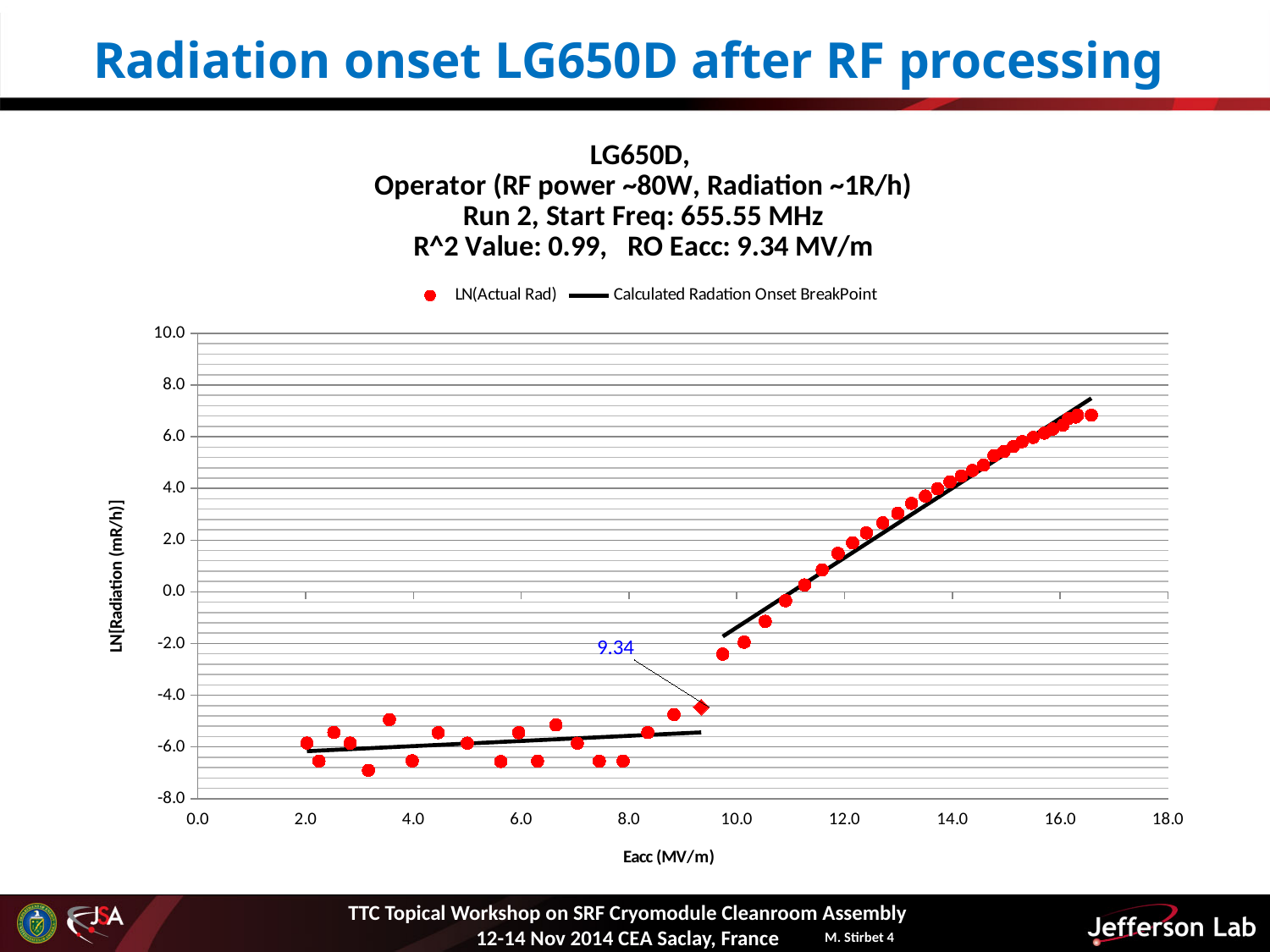
What is the maximum value shown on the y axis of the chart? 10.0 What is the label of the x axis of the chart? Eacc (MV/m) What are the two series named in the chart legend? LN(Actual Rad) and Calculated Radation Onset BreakPoint Is the LN(Actual Rad) value at the highest Eacc (around 16.5 MV/m) greater or less than 6.0? greater What kind of chart is shown on the slide? scatter chart What Eacc value is labeled at the calculated radiation onset breakpoint on the chart? 9.34 How many series does the chart legend list? 2 According to the chart title, what is the R^2 value of the fit? 0.99 Which is larger: the LN(Actual Rad) value at Eacc of about 14.0 MV/m or at about 10.0 MV/m? at about 14.0 MV/m Is the LN(Actual Rad) value at Eacc of about 2.0 MV/m greater or less than -4.0? less According to the chart title, what is the RO Eacc value? 9.34 MV/m Do the LN(Actual Rad) values rise or fall as Eacc increases beyond the 9.34 MV/m breakpoint? rise